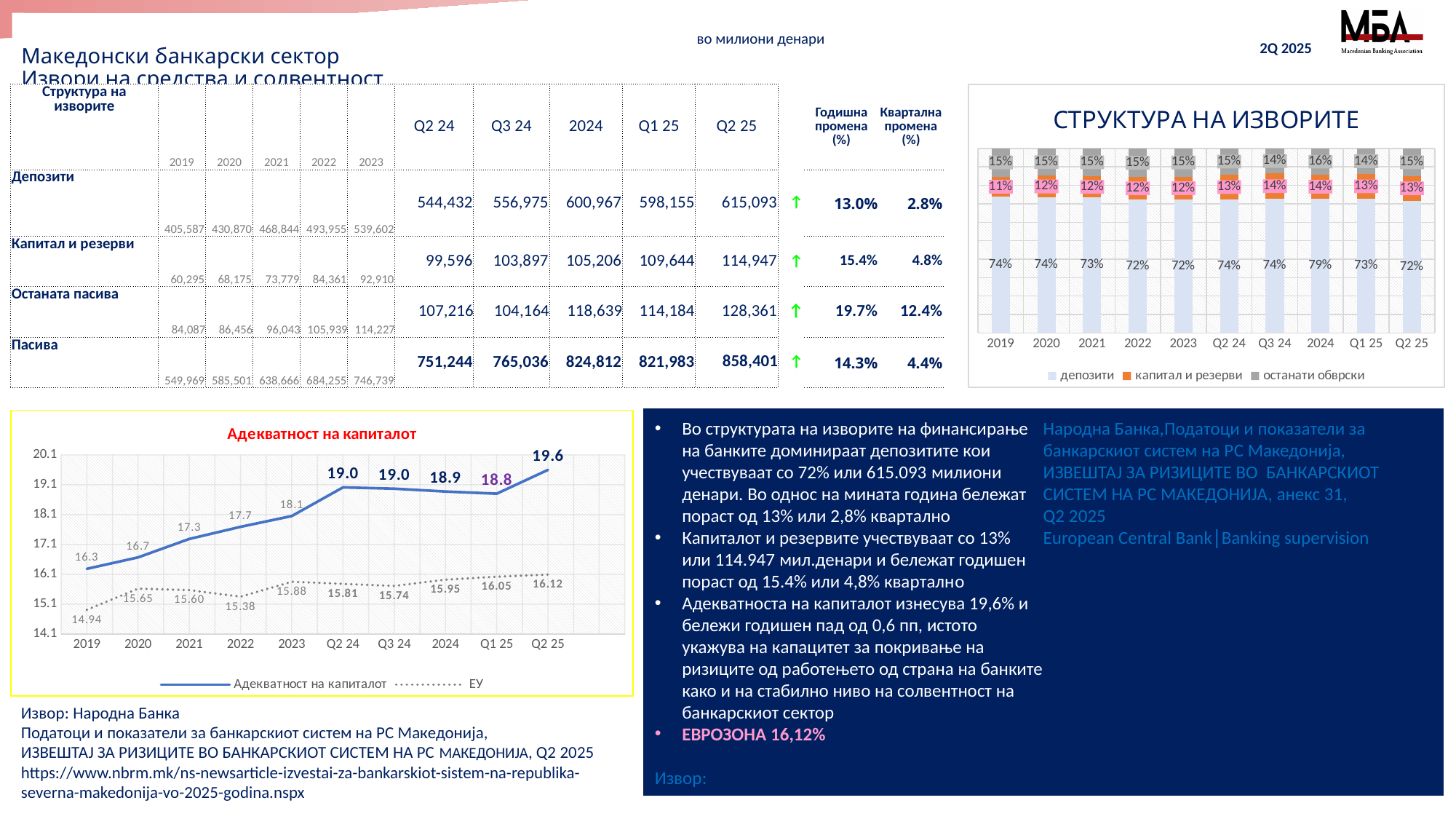
How many series does the legend of the "СТРУКТУРА НА ИЗВОРИТЕ" chart list? 3 In the "Адекватност на капиталот" chart, which period has the lowest ЕУ value? 2019 In the "Адекватност на капиталот" chart, what is the ЕУ value for 2019? 14.94 In the "СТРУКТУРА НА ИЗВОРИТЕ" chart, what is the share of капитал и резерви for 2019? 11% In the "Адекватност на капиталот" chart, what is the value of Адекватност на капиталот for Q2 25? 19.6 What kind of chart is the "Адекватност на капиталот" chart? line chart How many periods are shown on the x axis of the "СТРУКТУРА НА ИЗВОРИТЕ" chart? 10 How many series does the legend of the "Адекватност на капиталот" chart list? 2 In the "СТРУКТУРА НА ИЗВОРИТЕ" chart, what is the share of депозити for Q2 25? 72% In the "Адекватност на капиталот" chart, which period has the highest value for Адекватност на капиталот? Q2 25 In the "Адекватност на капиталот" chart, does the Адекватност на капиталот line generally rise or fall from 2019 to Q2 25? rise In the "Адекватност на капиталот" chart, what is the difference between Адекватност на капиталот and ЕУ for Q2 25? 3.48